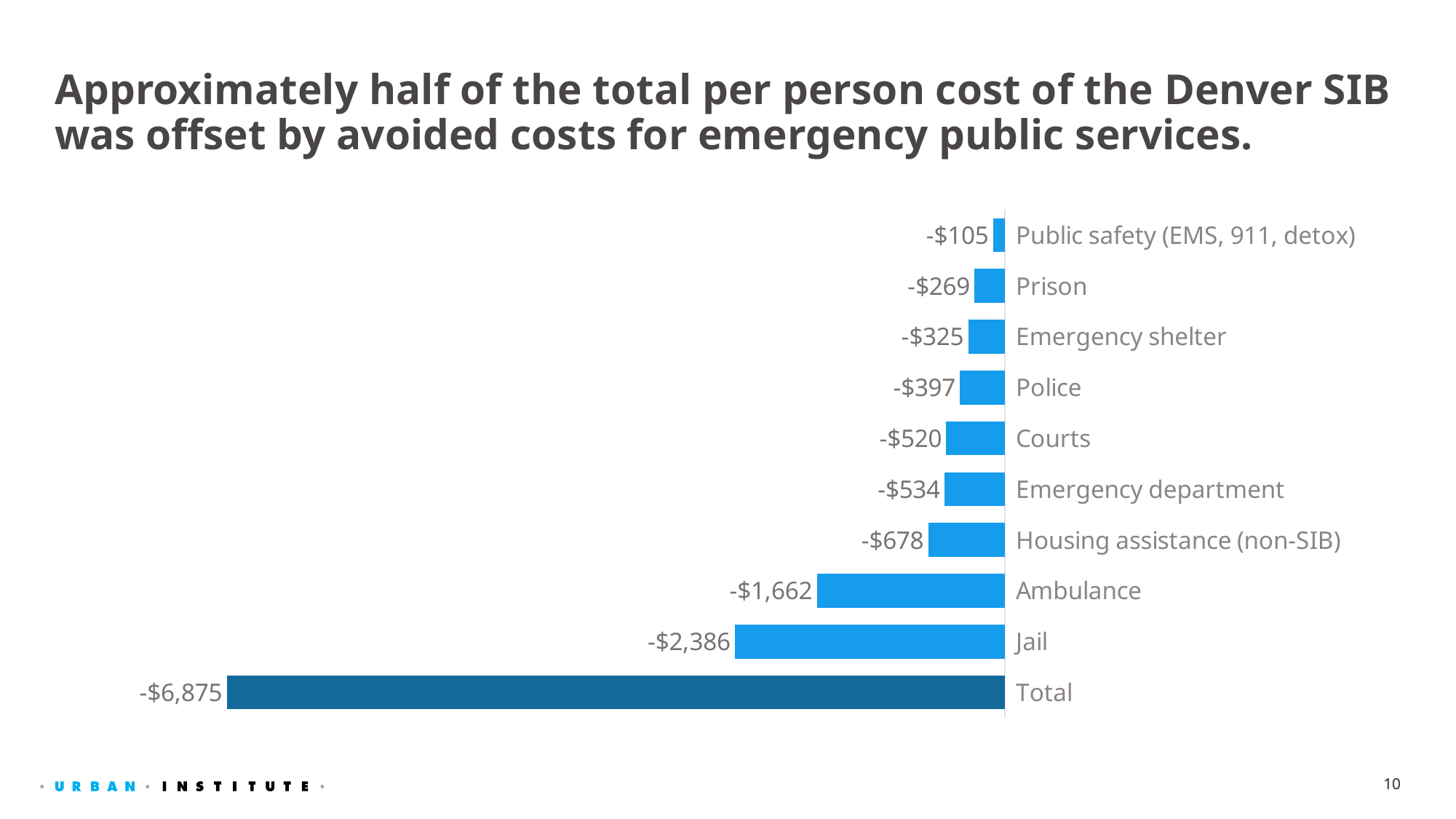
Excluding the Total bar, which category has the longest bar? Jail What is the value shown for Housing assistance (non-SIB)? -$678 What is the value shown for Jail? -$2,386 What is the difference in dollars between the Jail value and the Ambulance value? $724 Which category has the shortest bar? Public safety (EMS, 911, detox) Which bar is longer, Prison or Courts? Courts What is the difference in dollars between the Housing assistance (non-SIB) value and the Police value? $281 What is the value shown for the Total bar? -$6,875 What is the value shown for Ambulance? -$1,662 How many bars are shown in the chart? 10 What is the value shown for Emergency shelter? -$325 What kind of chart is shown on the slide? Bar chart